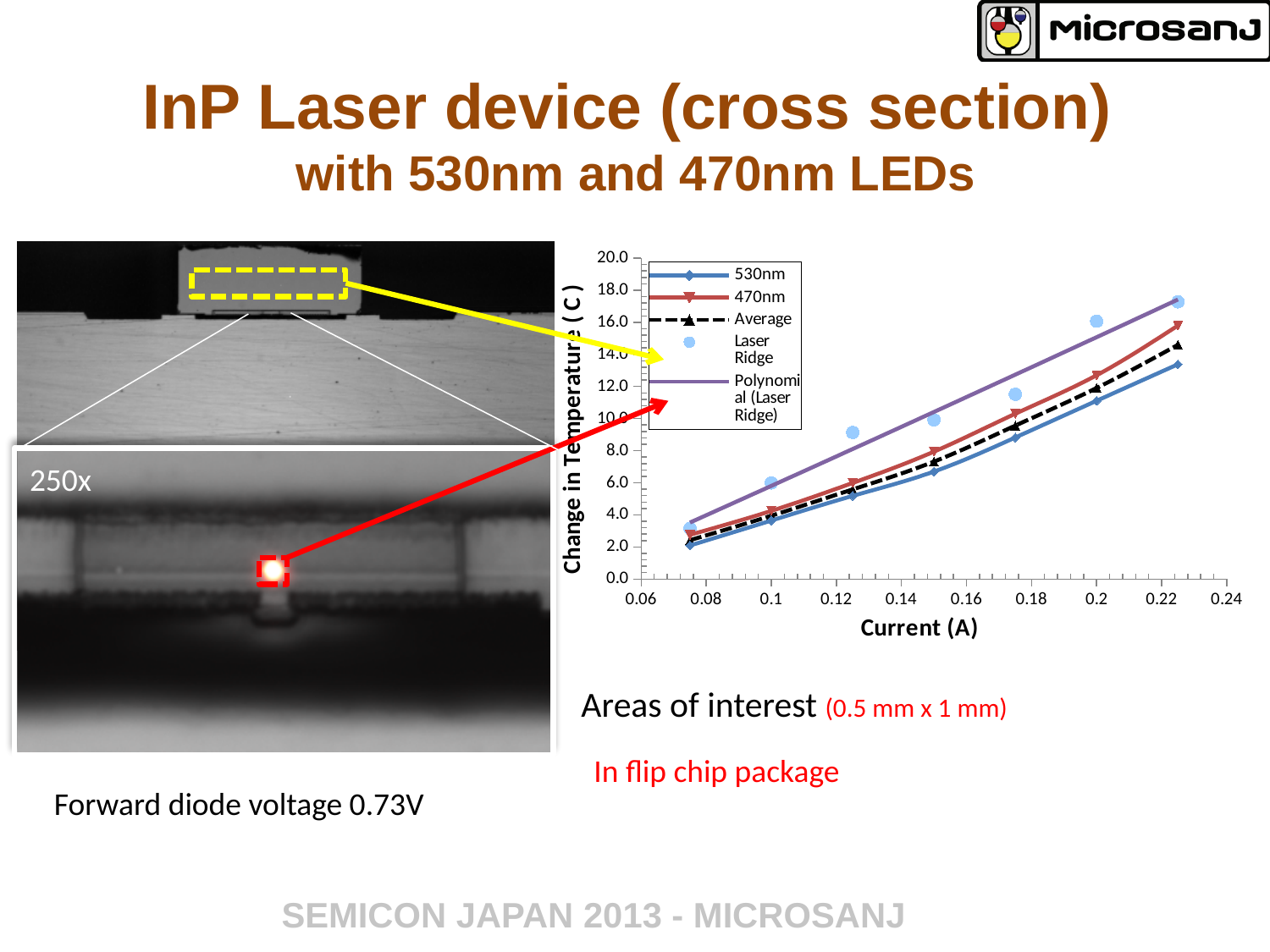
Is the value of the 470nm series at a current of 0.225 A greater or less than 14.0? greater At a current of 0.2 A, which series has the larger value, Laser Ridge or 530nm? Laser Ridge How many data points are plotted for the 530nm series? 7 Is the value of the 530nm series at a current of 0.075 A greater or less than 4.0? less What is the title of the x axis of the chart? Current (A) Is the value of the Laser Ridge series at a current of 0.225 A greater or less than 16.0? greater At a current of 0.225 A, which series has the larger value, 470nm or 530nm? 470nm How many series does the chart legend list? 5 Do the values of the 530nm series rise or fall as current increases along the x axis? rise What kind of chart is shown on the slide? line chart